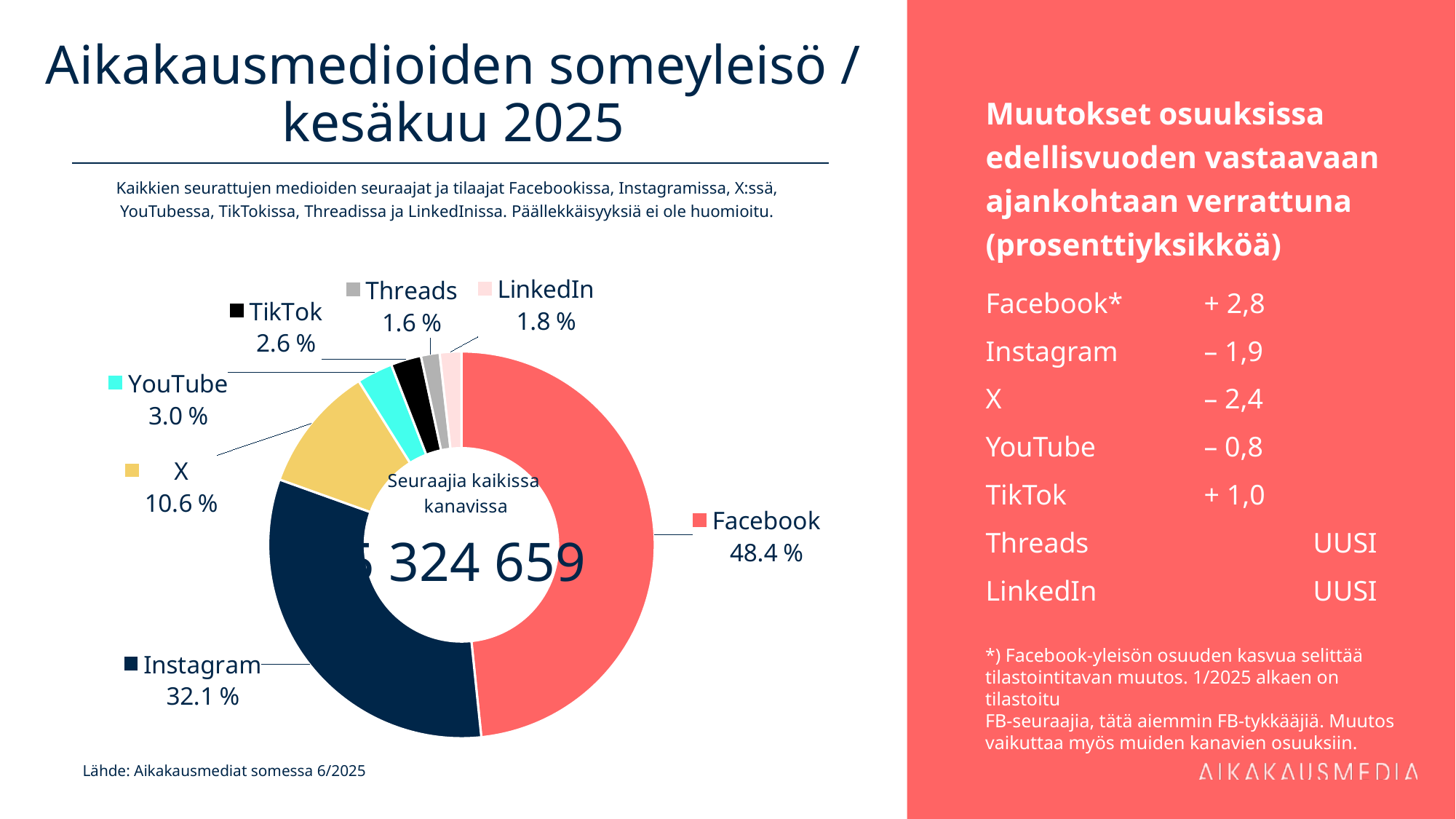
What kind of chart is shown on the slide? Pie chart (donut) Which channel has the largest slice of the pie? Facebook What is the difference between LinkedIn's and Threads' shares? 0.2 % Which channel has the smallest slice of the pie? Threads How many channels (slices) are shown in the pie chart? 7 What share of the pie does Instagram have? 32.1 % What is the difference in percentage points between Facebook's and Instagram's shares? 16.3 % What is the value shown for TikTok in the pie chart? 2.6 % What is the value shown for X in the pie chart? 10.6 % What share of the pie does Facebook have? 48.4 % What colour is the Instagram slice in the pie chart? Dark navy blue Which has a larger share, YouTube or TikTok? YouTube